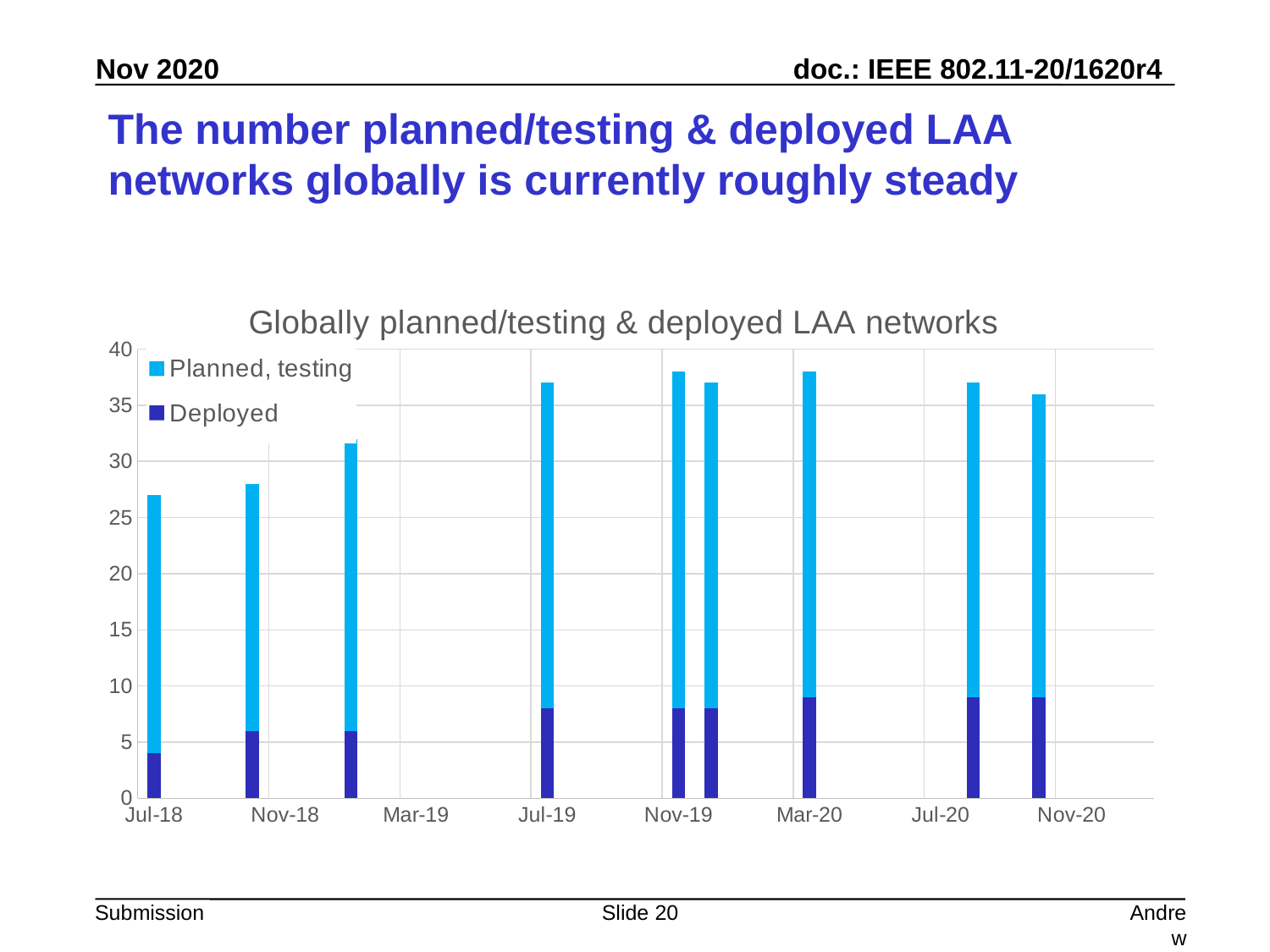
Is the Deployed value at Jul-18 greater or less than 5? less Is the total value of the bar at Nov-19 greater or less than 35? greater Is the total bar at Jul-19 larger or smaller than the total bar at Nov-18? larger How many series does the legend list? 2 How many bars are plotted in the chart? 9 Is the total value of the bar at Jul-18 greater or less than 25? greater What are the two series named in the legend? Planned, testing; Deployed Which date has the lowest total bar? Jul-18 What kind of chart is shown on the slide? Stacked bar chart What is the title of the chart? Globally planned/testing & deployed LAA networks